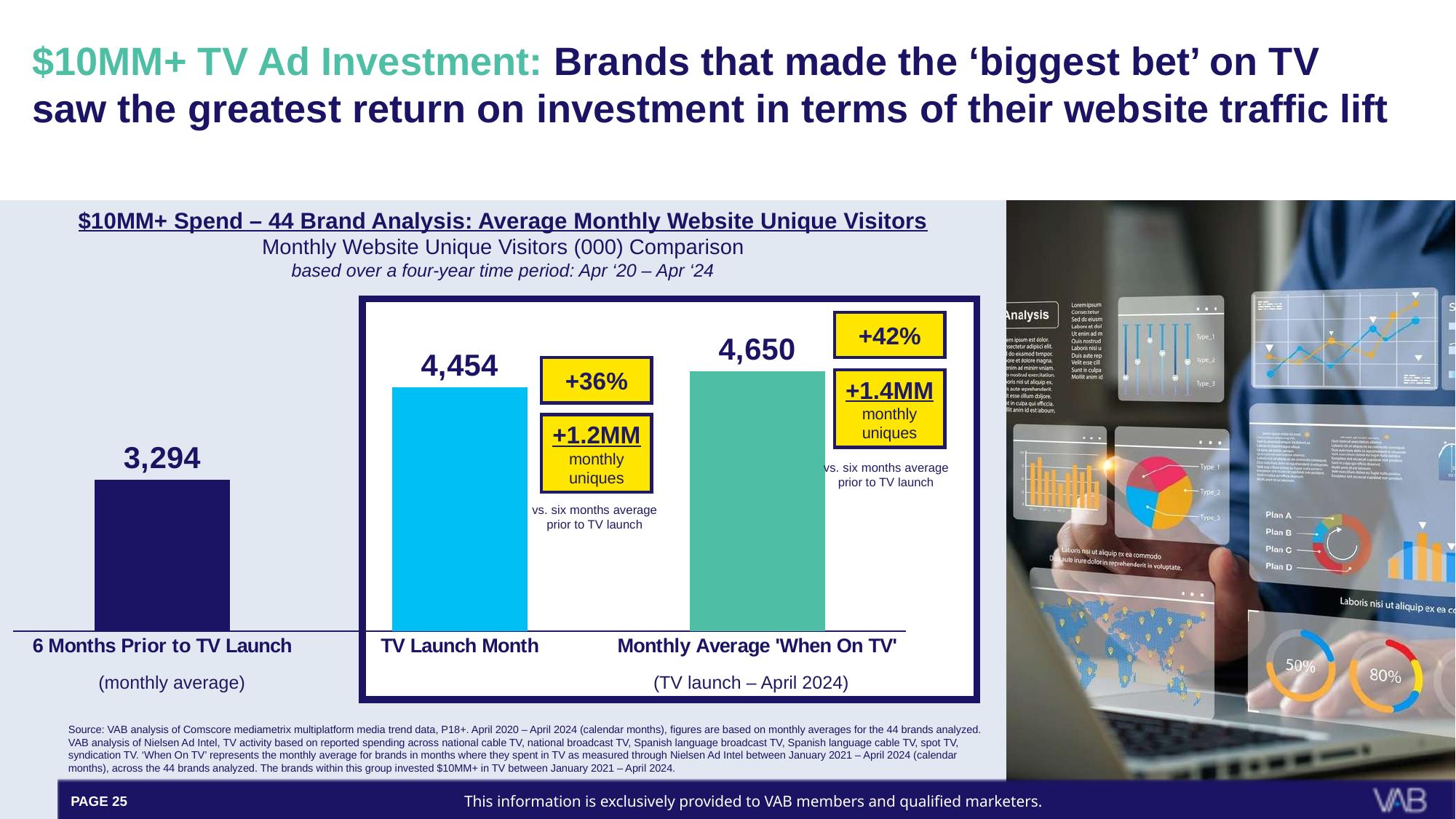
Which is larger, the value for 'TV Launch Month' or the value for '6 Months Prior to TV Launch'? TV Launch Month What is the value for 'Monthly Average "When On TV"'? 4,650 What is the value for 'TV Launch Month'? 4,454 How many bars are shown in the chart? 3 Do the values rise or fall from left to right across the chart? Rise What is the value for '6 Months Prior to TV Launch'? 3,294 What kind of chart is shown on the slide? Bar chart What is the difference between the 'TV Launch Month' value and the '6 Months Prior to TV Launch' value? 1,160 What percentage lift is shown in the callout next to the 'Monthly Average "When On TV"' bar? +42% Which category has the lowest value? 6 Months Prior to TV Launch Which category has the highest value? Monthly Average 'When On TV' What is the difference between the 'Monthly Average "When On TV"' value and the 'TV Launch Month' value? 196